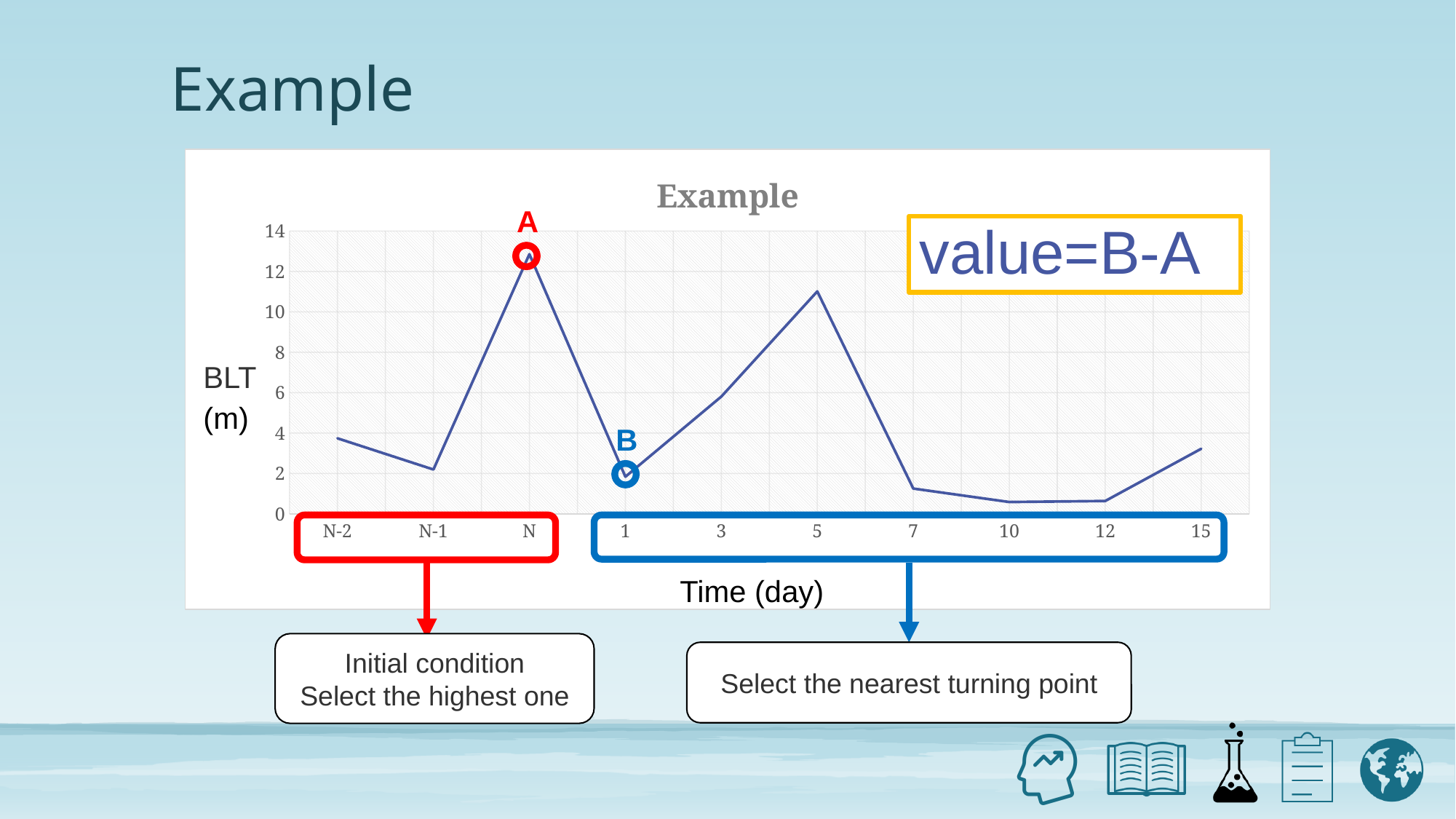
What is the label on the y axis of the chart? BLT (m) Which is larger, the value at N or the value at day 5? N Is the value at day 5 greater or less than 10? greater How many points are plotted along the x axis of the chart? 10 Is the value at N greater or less than 12? greater Which x-axis category has the highest BLT value? N Is the value at N-1 greater or less than 4? less Do the values rise or fall from N to day 1? fall What is the label on the x axis of the chart? Time (day) Which is larger, the value at N-2 or the value at N-1? N-2 What kind of chart is shown on the slide? line chart